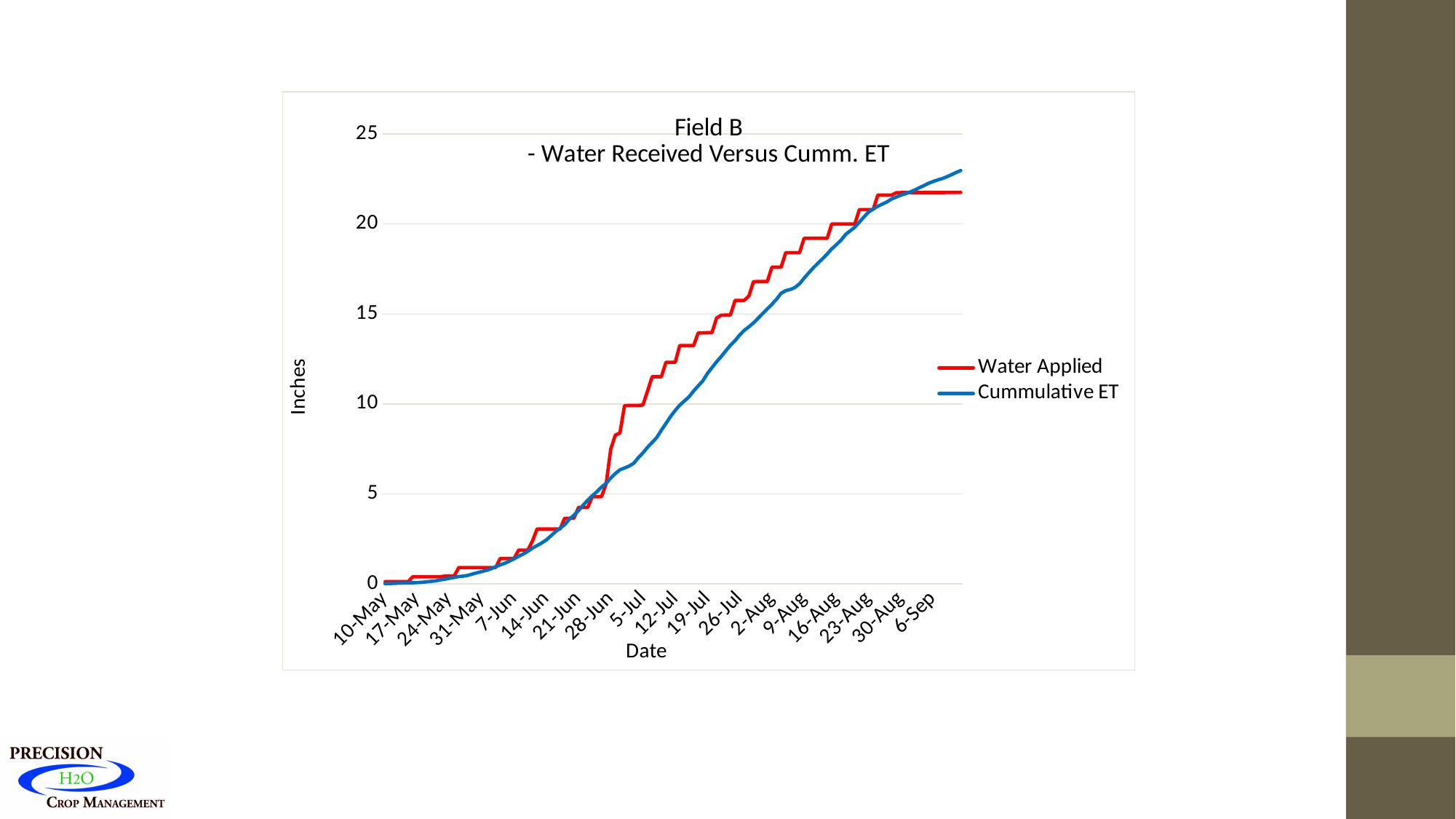
How many series does the legend list? 2 Is the value for Water Applied at 6-Sep greater or less than 20? greater Which colour is used for the Water Applied series? red Does the Cummulative ET line rise or fall along the x axis? rise What type of chart is shown on the slide? line chart Does the Water Applied line rise or fall from 10-May to 6-Sep? rise Is the value for Water Applied at 2-Aug greater or less than 15? greater What is the title of the chart? Field B - Water Received Versus Cumm. ET How many date labels are shown on the x axis? 18 At 6-Sep, which series is higher, Water Applied or Cummulative ET? Cummulative ET Is the value for Cummulative ET at 5-Jul greater or less than 10? less At 12-Jul, which series is higher, Water Applied or Cummulative ET? Water Applied